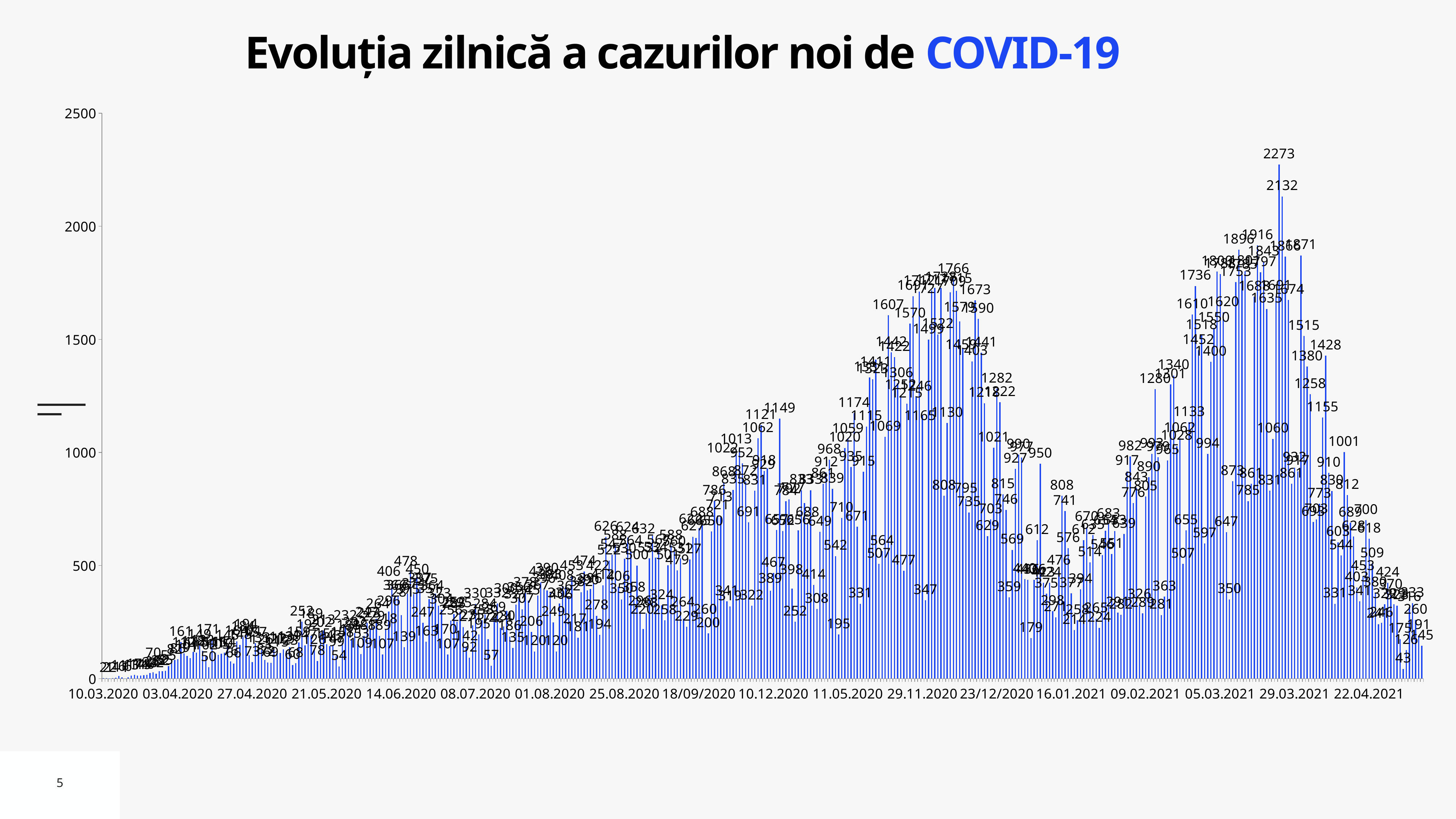
Is the highest bar on the chart greater or less than 2000? greater What is the topmost tick value on the vertical axis? 2500 What is the highest daily value labelled on the chart? 2273 What kind of chart is shown on the slide? bar chart What is the second highest daily value labelled on the chart, next to the 2273 peak? 2132 Is the value for 22.04.2021 greater or less than 1000? less What is the last date label on the horizontal axis? 22.04.2021 What is the first date label on the horizontal axis? 10.03.2020 Do the values generally rise or fall between 10.03.2020 and 14.06.2020? rise What is the difference between the two highest labelled values, 2273 and 2132? 141 What is the title of the chart? Evoluția zilnică a cazurilor noi de COVID-19 Is the value for 10.03.2020 greater or less than 500? less